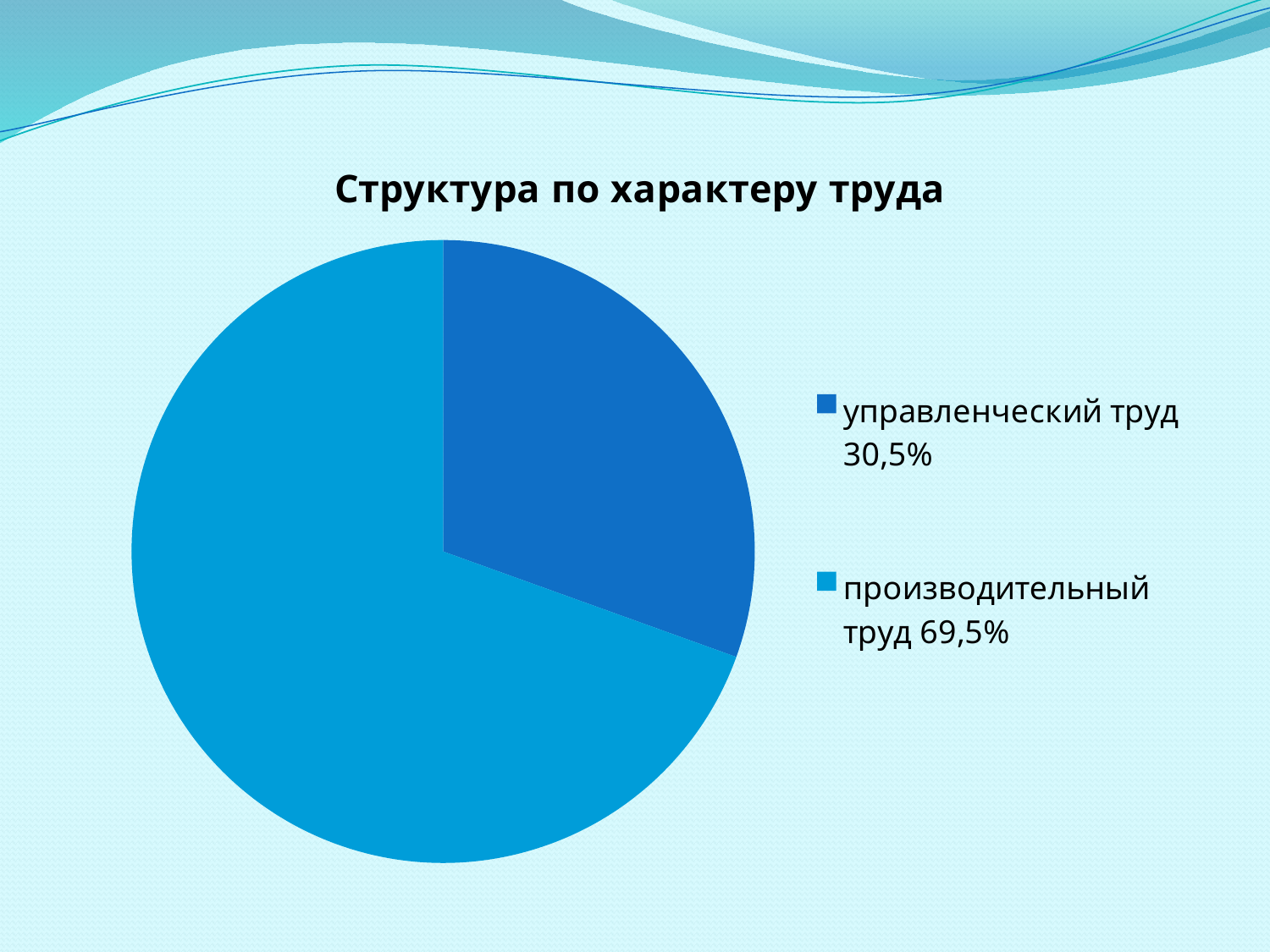
What kind of chart is shown on the slide? pie chart What share of the pie is управленческий труд? 30,5% Which category has the smallest slice of the pie? управленческий труд Which legend entry is shown in the lighter blue colour? производительный труд 69,5% How many slices does the pie chart have? 2 Which is larger: управленческий труд or производительный труд? производительный труд Is the share for управленческий труд greater or less than 50%? less What is the difference in percentage points between производительный труд and управленческий труд? 39 percentage points How many entries does the legend list? 2 Which category has the largest slice of the pie? производительный труд What share of the pie is производительный труд? 69,5% What is the title of the chart? Структура по характеру труда